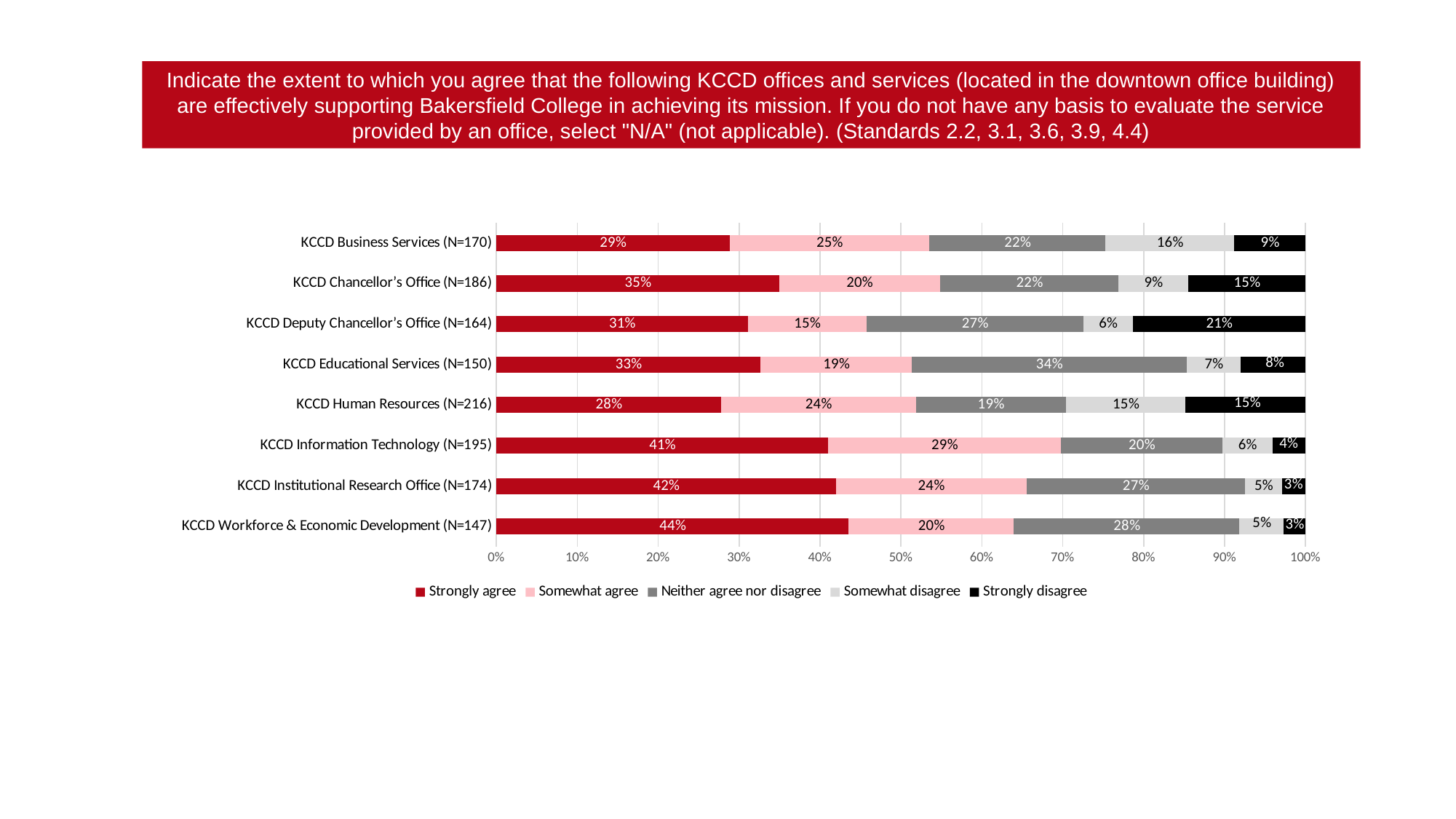
Which office has the lowest Strongly agree percentage? KCCD Human Resources (N=216) How many response categories does the legend list? 5 How many KCCD offices or services are shown in the chart? 8 What is the difference in percentage points between the Strongly agree values for KCCD Workforce & Economic Development and KCCD Human Resources? 16 percentage points Which has a larger Somewhat agree value: KCCD Information Technology or KCCD Chancellor's Office? KCCD Information Technology What percentage of respondents strongly agree that KCCD Information Technology is effectively supporting Bakersfield College? 41% Which office has the highest Strongly agree percentage? KCCD Workforce & Economic Development (N=147) What type of chart is shown on the slide? Stacked bar chart What is the Somewhat disagree value for KCCD Business Services (N=170)? 16% What is the Neither agree nor disagree value for KCCD Educational Services (N=150)? 34% What is the combined Strongly agree and Somewhat agree percentage for KCCD Information Technology (N=195)? 70% Which office has the highest Strongly disagree percentage? KCCD Deputy Chancellor's Office (N=164)